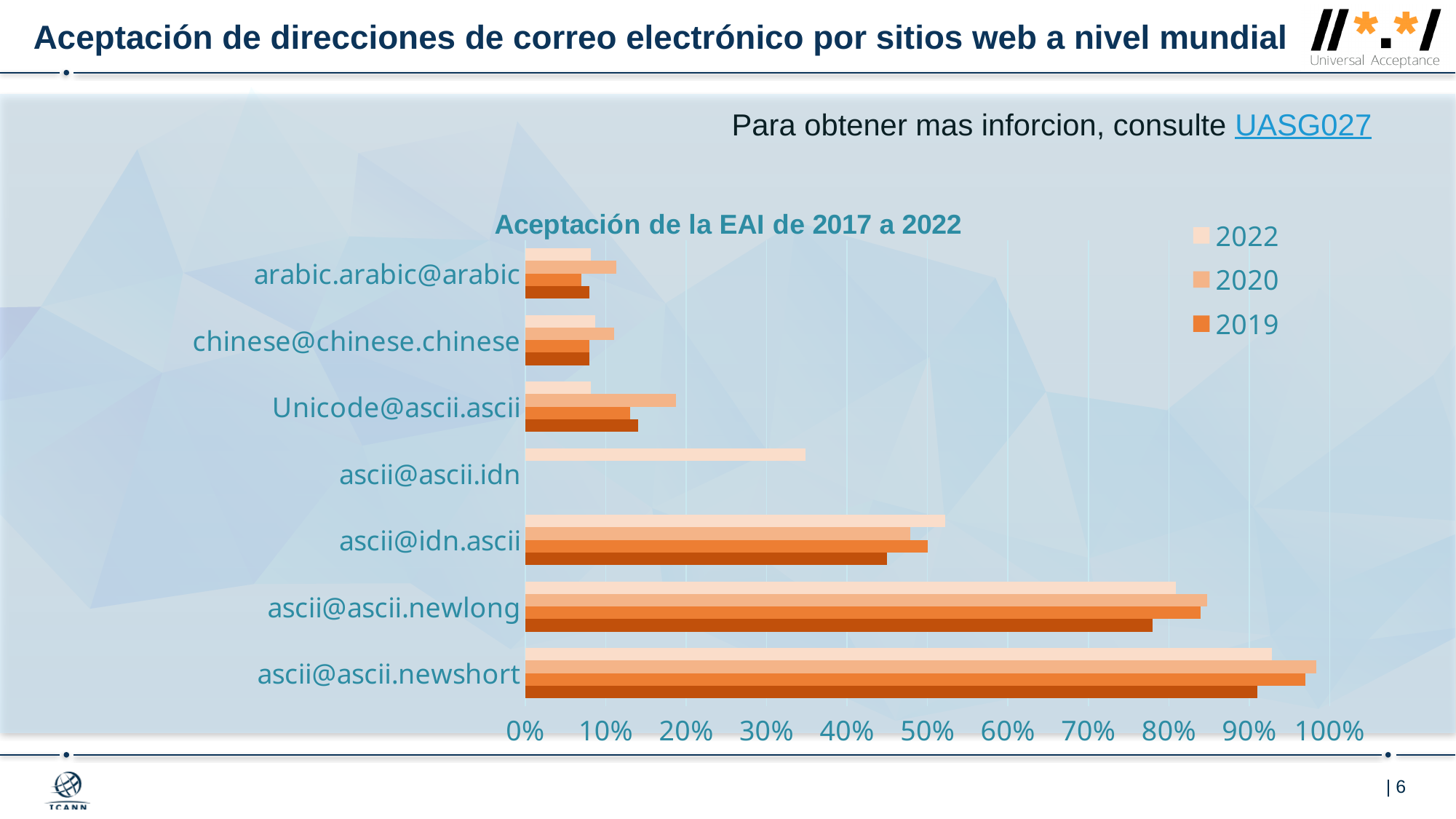
Is the 2020 value for Unicode@ascii.ascii greater or less than 20%? less What kind of chart is shown on the slide? bar chart Is the 2022 value for ascii@ascii.newshort greater or less than 90%? greater Which has the larger 2022 value, ascii@ascii.newlong or ascii@idn.ascii? ascii@ascii.newlong Which category has the highest value for 2022? ascii@ascii.newshort Is the 2022 value for ascii@ascii.idn greater or less than 30%? greater How many series does the chart legend list? 3 How many categories (email address types) are shown on the chart? 7 Which has the larger 2020 value, ascii@ascii.newshort or chinese@chinese.chinese? ascii@ascii.newshort What is the title of the chart? Aceptación de la EAI de 2017 a 2022